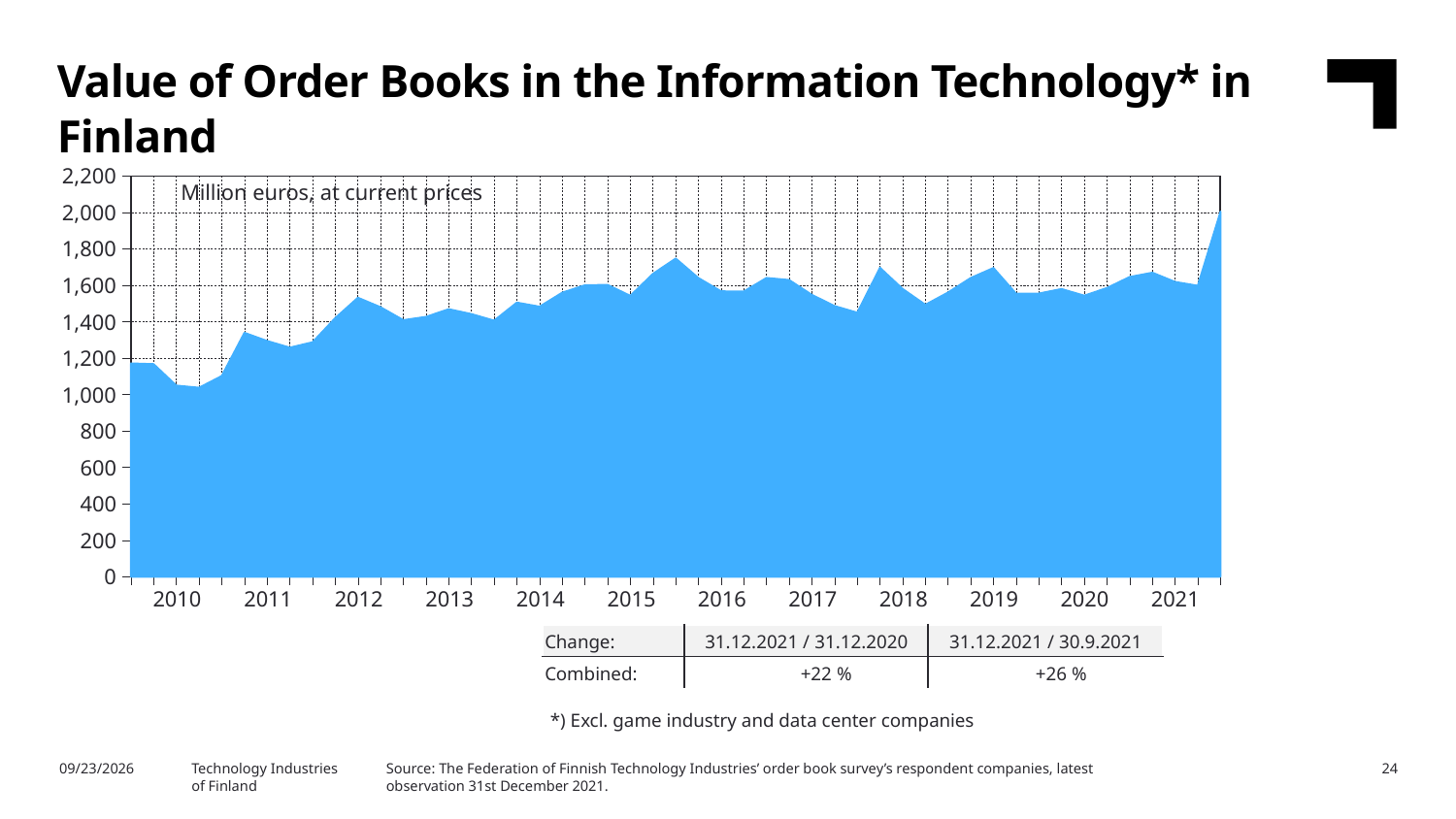
Is the lowest value in 2010 greater or less than 1,200? less What type of chart is shown on the slide? Area chart Is the value at the end of 2021 greater or less than 1,800? greater What unit is the value of order books measured in, according to the label inside the chart? Million euros, at current prices Overall, do the order book values rise or fall from 2010 to 2021? Rise Is the peak value in 2015 greater or less than 1,600? greater According to the table below the chart, what is the combined change from 30.9.2021 to 31.12.2021? +26 % According to the table below the chart, what is the combined change from 31.12.2020 to 31.12.2021? +22 % Which is larger, the value at the end of 2021 or the value at the end of 2020? End of 2021 In which year does the chart reach its lowest value? 2010 How many years are labelled on the x axis of the chart? 12 In which year does the chart reach its highest value? 2021